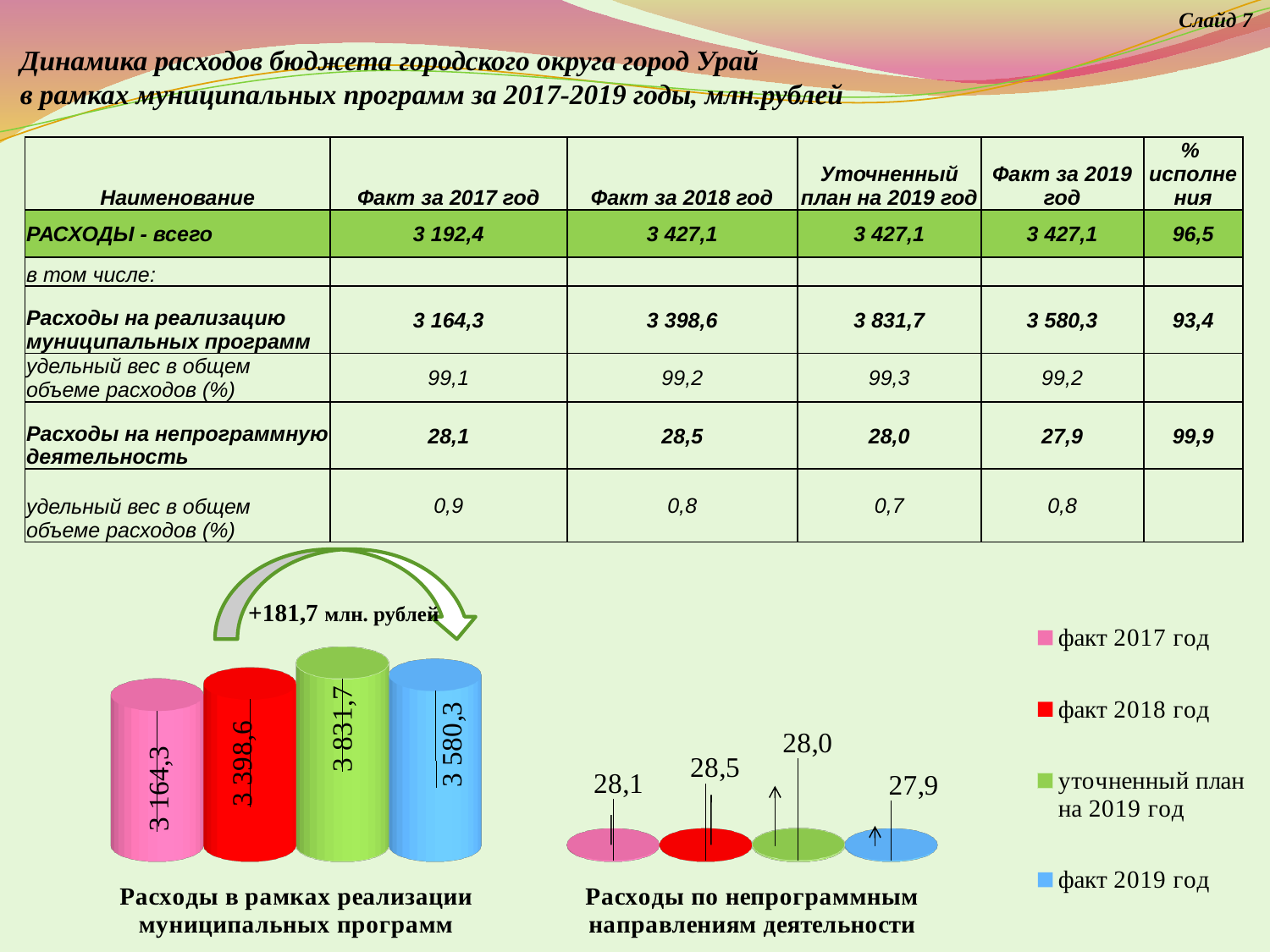
In the chart 'Расходы в рамках реализации муниципальных программ', which series has the lowest value? факт 2017 год In the chart 'Расходы по непрограммным направлениям деятельности', what is the difference between факт 2018 год and факт 2019 год? 0,6 In the chart 'Расходы в рамках реализации муниципальных программ', which series has the highest value? уточненный план на 2019 год What kind of chart is used for 'Расходы в рамках реализации муниципальных программ'? bar chart In the chart 'Расходы в рамках реализации муниципальных программ', what is the value for факт 2017 год? 3 164,3 How many series does the legend of the chart list? 4 In the chart 'Расходы в рамках реализации муниципальных программ', which is larger: факт 2019 год or факт 2018 год? факт 2019 год In the chart 'Расходы в рамках реализации муниципальных программ', what is the value for уточненный план на 2019 год? 3 831,7 In the chart 'Расходы по непрограммным направлениям деятельности', what is the value for факт 2018 год? 28,5 In the chart 'Расходы по непрограммным направлениям деятельности', which series has the highest value? факт 2018 год In the chart 'Расходы в рамках реализации муниципальных программ', what is the difference between факт 2018 год and факт 2017 год? 234,3 In the chart 'Расходы по непрограммным направлениям деятельности', what is the value for факт 2019 год? 27,9